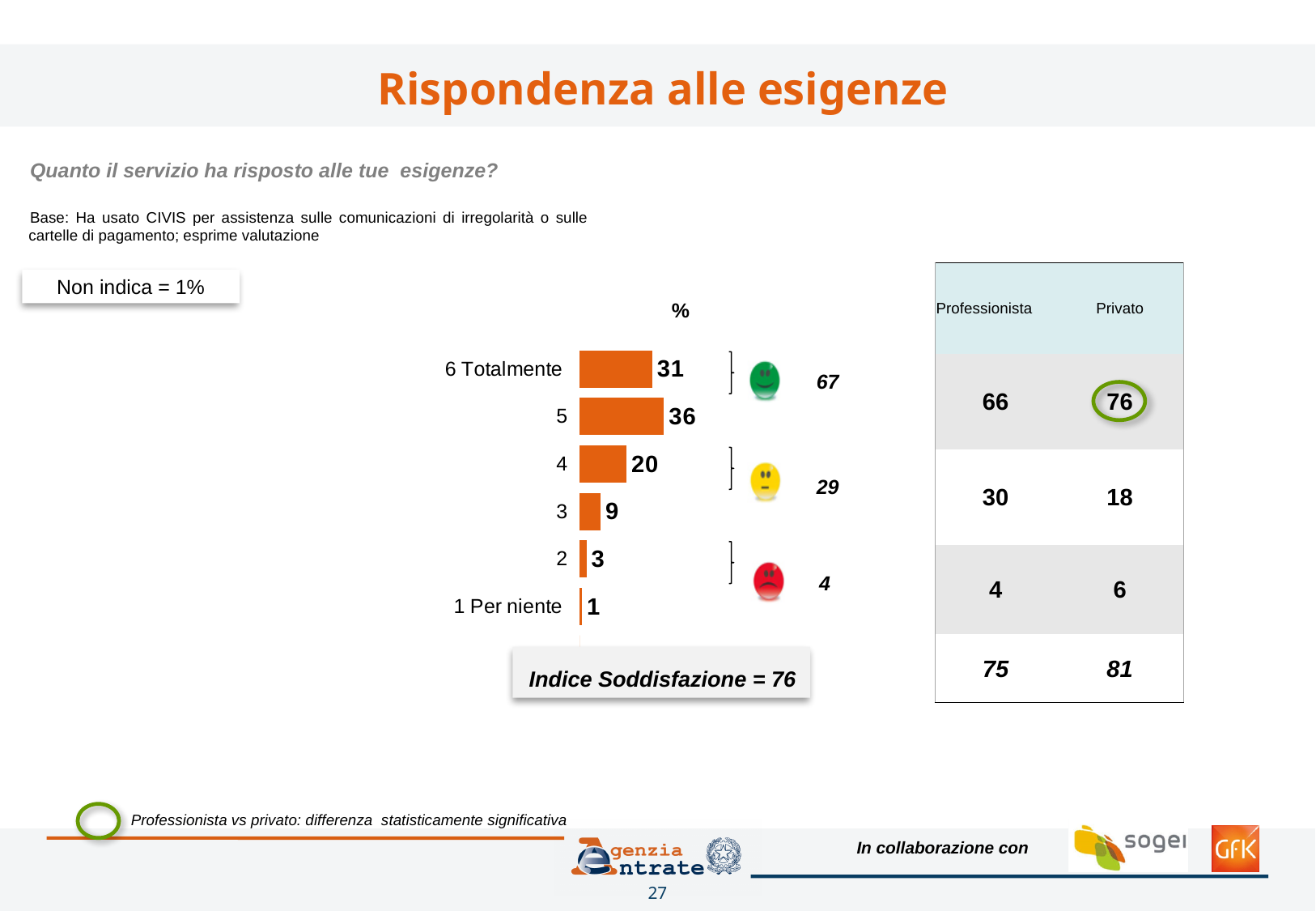
Which category has the highest value? 5 What is the difference between the values for "5" and "4"? 16 What is the value for the category "5"? 36 Which is larger, the value for "6 Totalmente" or the value for "4"? 6 Totalmente What kind of chart is shown on the slide? bar chart What is the combined value shown next to the green smiley for categories 6 and 5? 67 Which category has the lowest value? 1 Per niente How many categories are shown in the bar chart? 6 What is the combined value shown next to the red face for categories 2 and 1? 4 What is the value for the category "1 Per niente"? 1 What is the value of the "Indice Soddisfazione" shown below the chart? 76 What is the value for the category "6 Totalmente"? 31